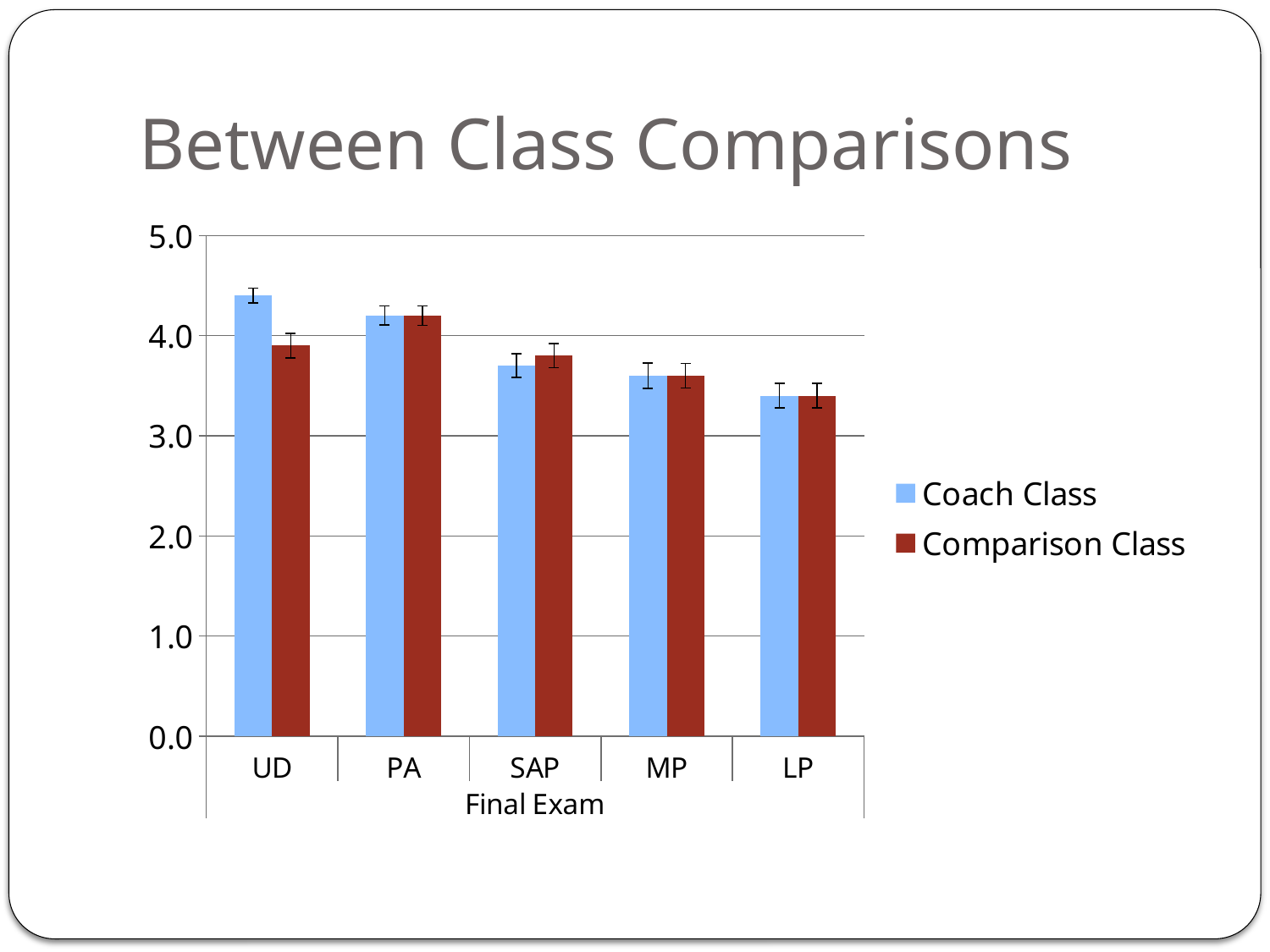
Which category has the highest Comparison Class value? PA Is the Coach Class value for LP greater or less than 3.0? greater Is the Comparison Class value for UD greater or less than 4.0? less Which category has the highest Coach Class value? UD How many series does the legend list? 2 Do the Coach Class values rise or fall from UD to LP along the x axis? fall What kind of chart is shown on the slide? bar chart For UD, which is larger: the Coach Class value or the Comparison Class value? Coach Class Which category has the lowest Comparison Class value? LP How many categories are shown on the x axis? 5 Which category has the lowest Coach Class value? LP Is the Coach Class value for UD greater or less than 4.0? greater